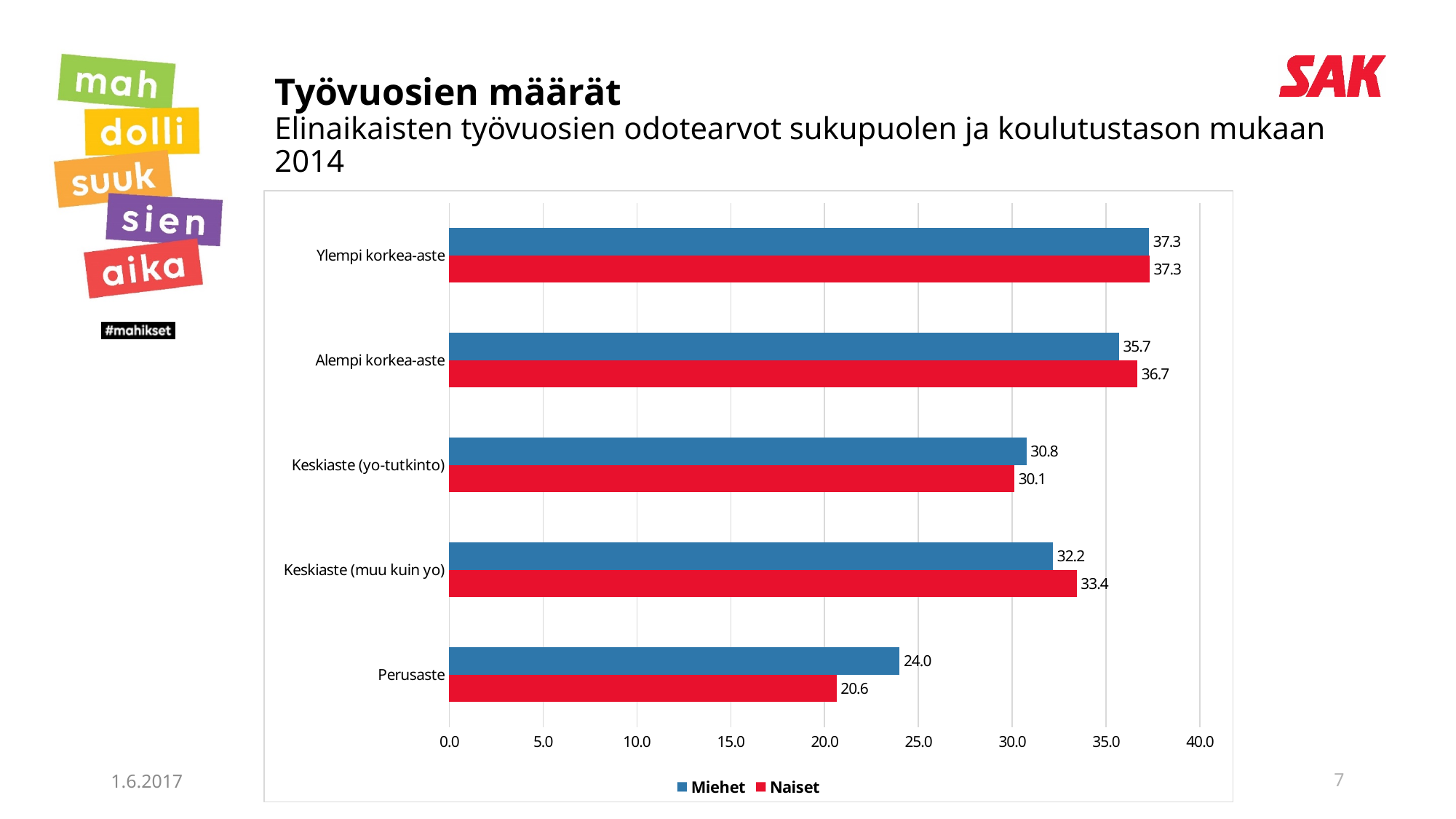
How many categories are shown on the chart? 5 What is the difference between the Miehet and Naiset values in the Perusaste category? 3.4 What is the value for Naiset in the Alempi korkea-aste category? 36.7 Which category has the highest value for Miehet? Ylempi korkea-aste What is the value for Miehet in the Perusaste category? 24.0 What is the difference between the Naiset and Miehet values in the Keskiaste (muu kuin yo) category? 1.2 What is the value for Naiset in the Keskiaste (yo-tutkinto) category? 30.1 Which category has the lowest value for Naiset? Perusaste What kind of chart is shown on the slide? bar chart In the Alempi korkea-aste category, which is larger, Miehet or Naiset? Naiset Is the value for Naiset in the Perusaste category greater or less than 25.0? less How many series does the legend list? 2